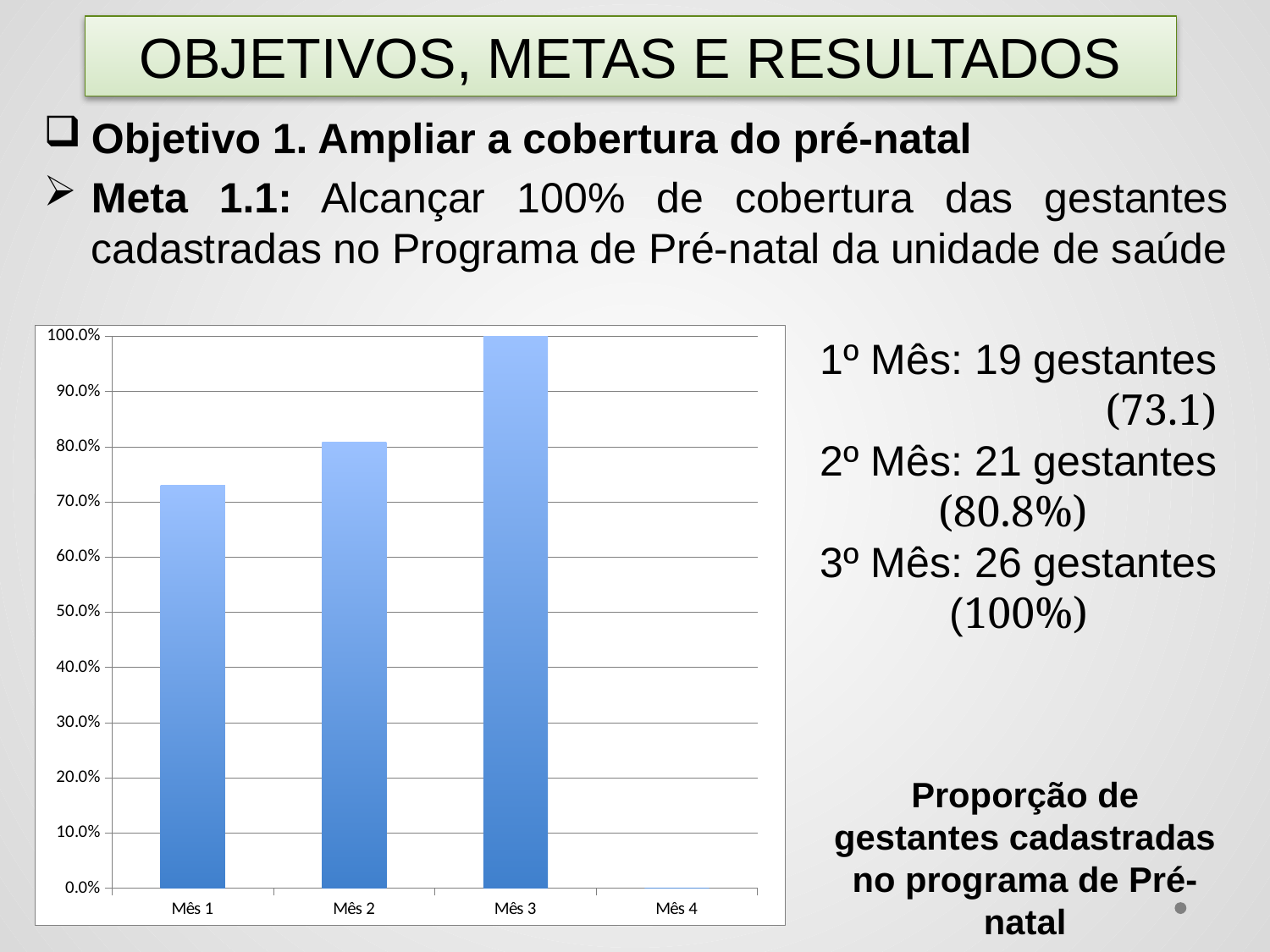
Is the value for Mês 2 greater or less than 90.0%? less What kind of chart is shown on the slide? bar chart Do the bar values rise or fall from Mês 1 to Mês 3? rise Is the value for Mês 1 greater or less than 70.0%? greater How many categories are labelled on the x axis of the chart? 4 What value does the bar for Mês 3 reach on the y axis? 100.0% Which has the larger value, Mês 1 or Mês 2? Mês 2 Which month on the x axis has no bar plotted? Mês 4 Is the value for Mês 2 greater or less than 80.0%? greater Which month has the highest bar in the chart? Mês 3 What is the highest value shown on the chart's y axis? 100.0%